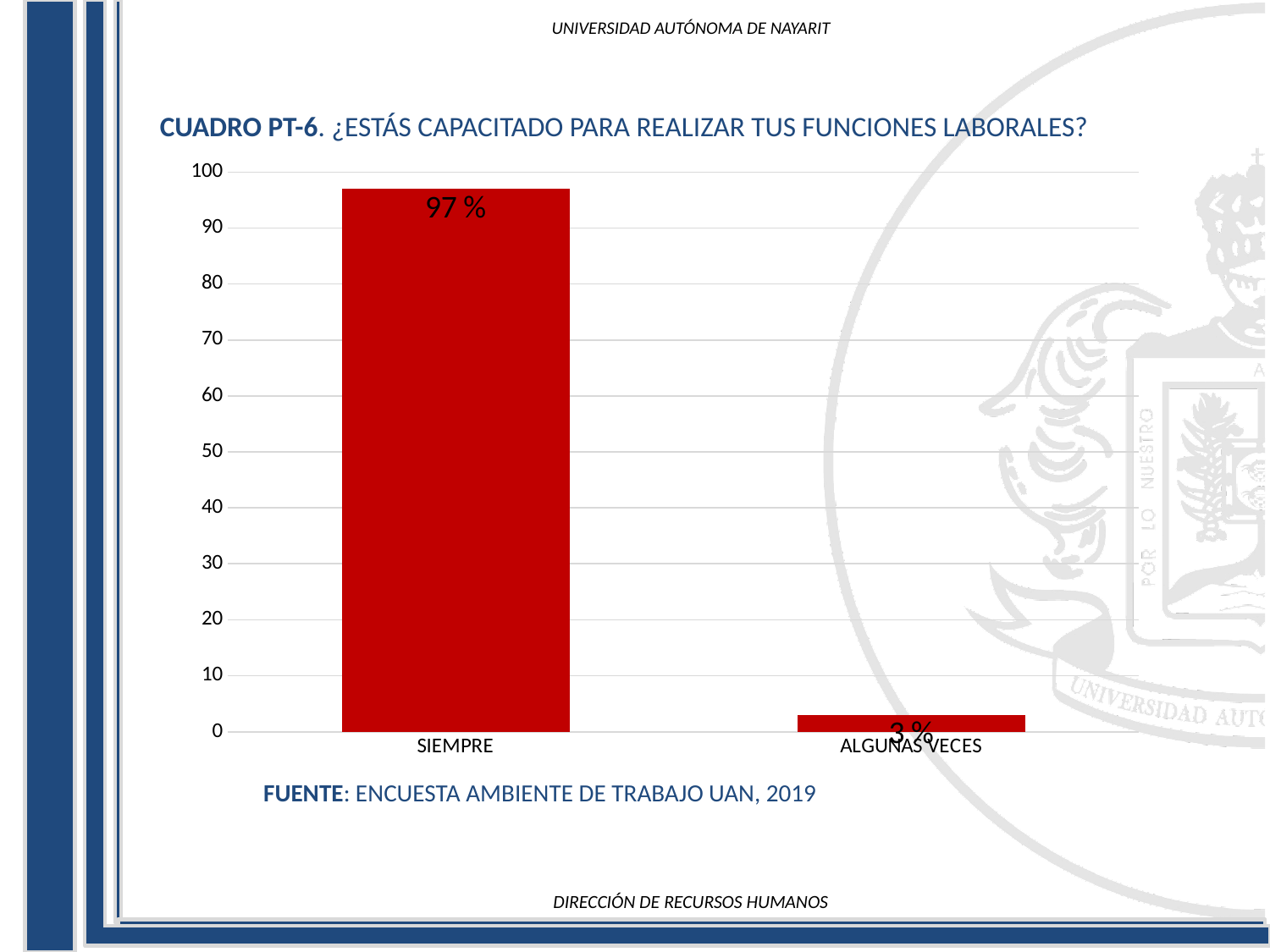
What kind of chart is shown on the slide? bar chart Which is larger, the value for SIEMPRE or the value for ALGUNAS VECES? SIEMPRE Which category has the lowest value? ALGUNAS VECES What is the value for ALGUNAS VECES? 3 % How many categories are shown on the x axis? 2 What is the value for SIEMPRE? 97 % What is the source cited below the chart? ENCUESTA AMBIENTE DE TRABAJO UAN, 2019 Is the value for ALGUNAS VECES greater or less than 10? less What colour are the bars in the chart? red Which category has the highest value? SIEMPRE Is the value for SIEMPRE greater or less than 90? greater What is the difference between the values for SIEMPRE and ALGUNAS VECES? 94 %